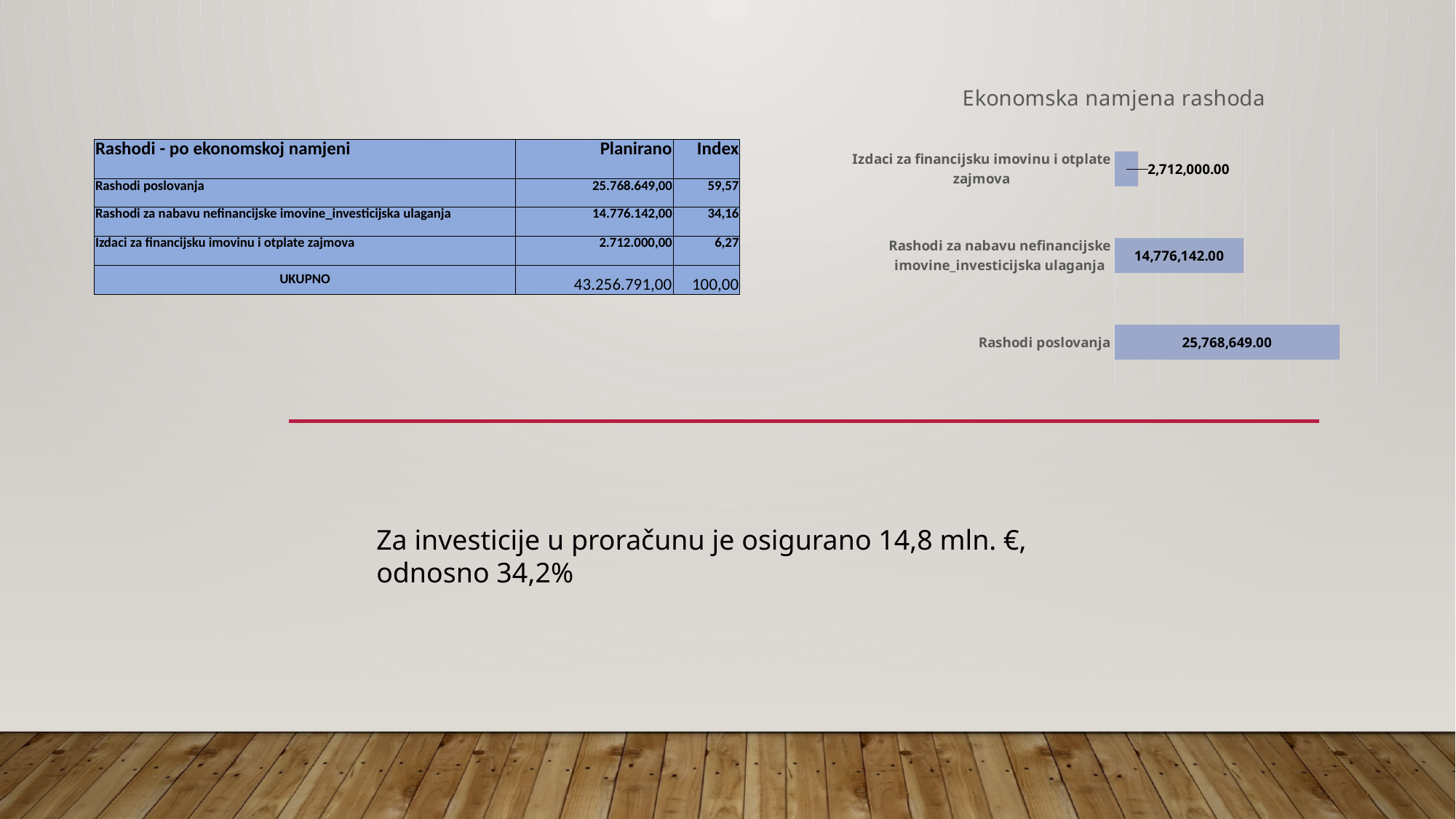
What is the total of the three values shown in the chart? 43,256,791.00 What is the difference between the values for Rashodi za nabavu nefinancijske imovine_investicijska ulaganja and Izdaci za financijsku imovinu i otplate zajmova? 12,064,142.00 What kind of chart is shown on the slide? bar chart Which is larger: the value for Rashodi poslovanja or the value for Izdaci za financijsku imovinu i otplate zajmova? Rashodi poslovanja What is the difference between the values for Rashodi poslovanja and Rashodi za nabavu nefinancijske imovine_investicijska ulaganja? 10,992,507.00 What is the value for Izdaci za financijsku imovinu i otplate zajmova? 2,712,000.00 What is the value for Rashodi poslovanja? 25,768,649.00 What is the value for Rashodi za nabavu nefinancijske imovine_investicijska ulaganja? 14,776,142.00 Which category has the lowest value? Izdaci za financijsku imovinu i otplate zajmova Which category has the highest value? Rashodi poslovanja How many categories does the chart show? 3 What is the title of the chart? Ekonomska namjena rashoda